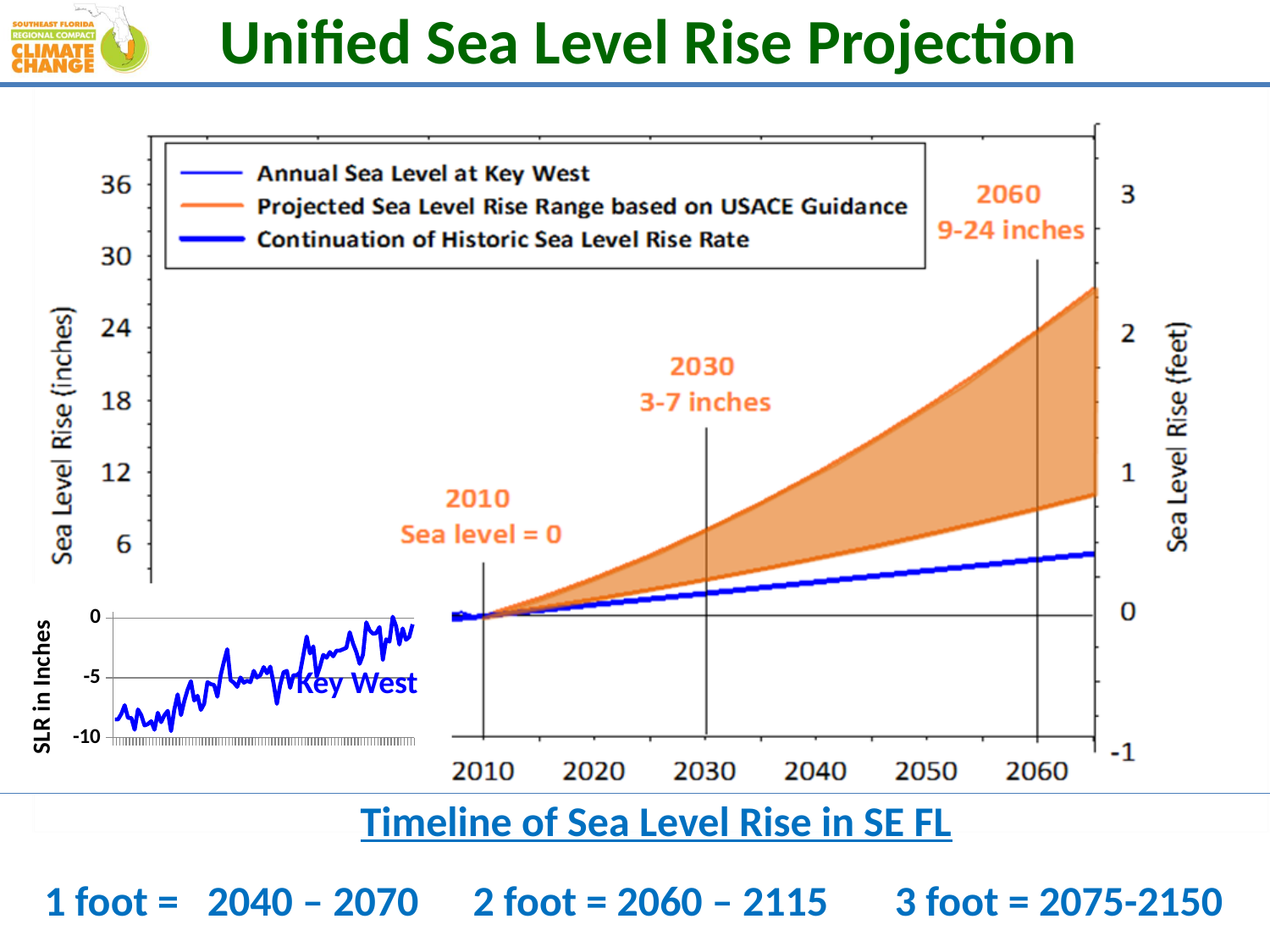
What sea level value is labelled for 2010 on the main chart? Sea level = 0 What projected sea level rise range is labelled for 2030 on the main chart? 3-7 inches On the main chart, does the projected sea level rise range rise or fall from 2010 to 2060? rise What is the label of the right-hand y axis on the main chart? Sea Level Rise (feet) On the main chart, is the Continuation of Historic Sea Level Rise Rate line at 2060 greater or less than 6 inches? less On the main chart, what is the difference between the upper and lower bounds of the projected range labelled for 2060? 15 inches Which legend entry on the main chart is drawn as a thick blue line? Continuation of Historic Sea Level Rise Rate How many series does the legend of the main chart list? 3 What kind of chart is the main chart on the slide? line chart How many year labels are shown on the x axis of the main chart? 6 On the main chart at 2060, which is higher: the upper bound of the Projected Sea Level Rise Range or the Continuation of Historic Sea Level Rise Rate line? Projected Sea Level Rise Range What projected sea level rise range is labelled for 2060 on the main chart? 9-24 inches